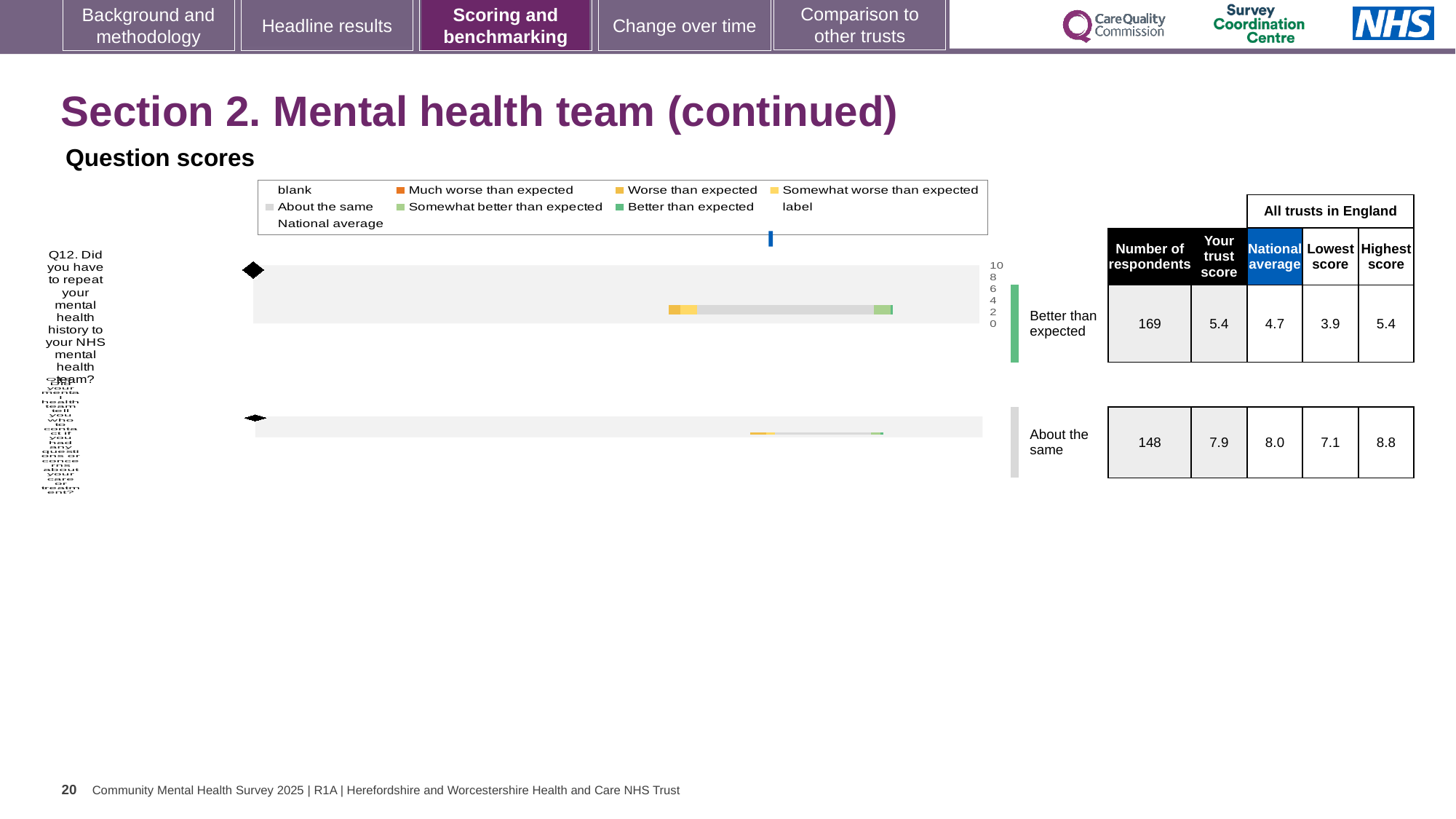
According to the table beside the chart, what is the trust score for Q12 (repeating mental health history)? 5.4 How many survey questions are plotted in the question scores chart? 2 For the second question row, which is larger: the trust score or the national average? the national average What benchmark category is Q12 given in the chart? Better than expected What is the difference between the trust score and the national average for Q12? 0.7 What kind of chart is used to show the question scores on this slide? bar chart What colour does the legend use for 'Better than expected'? green How many respondents answered Q12? 169 According to the table beside the chart, what is the national average for Q12? 4.7 For Q12, which is larger: the trust score or the national average? the trust score What is the highest score among all trusts in England for Q12? 5.4 What benchmark category is the second question row in the chart given? About the same